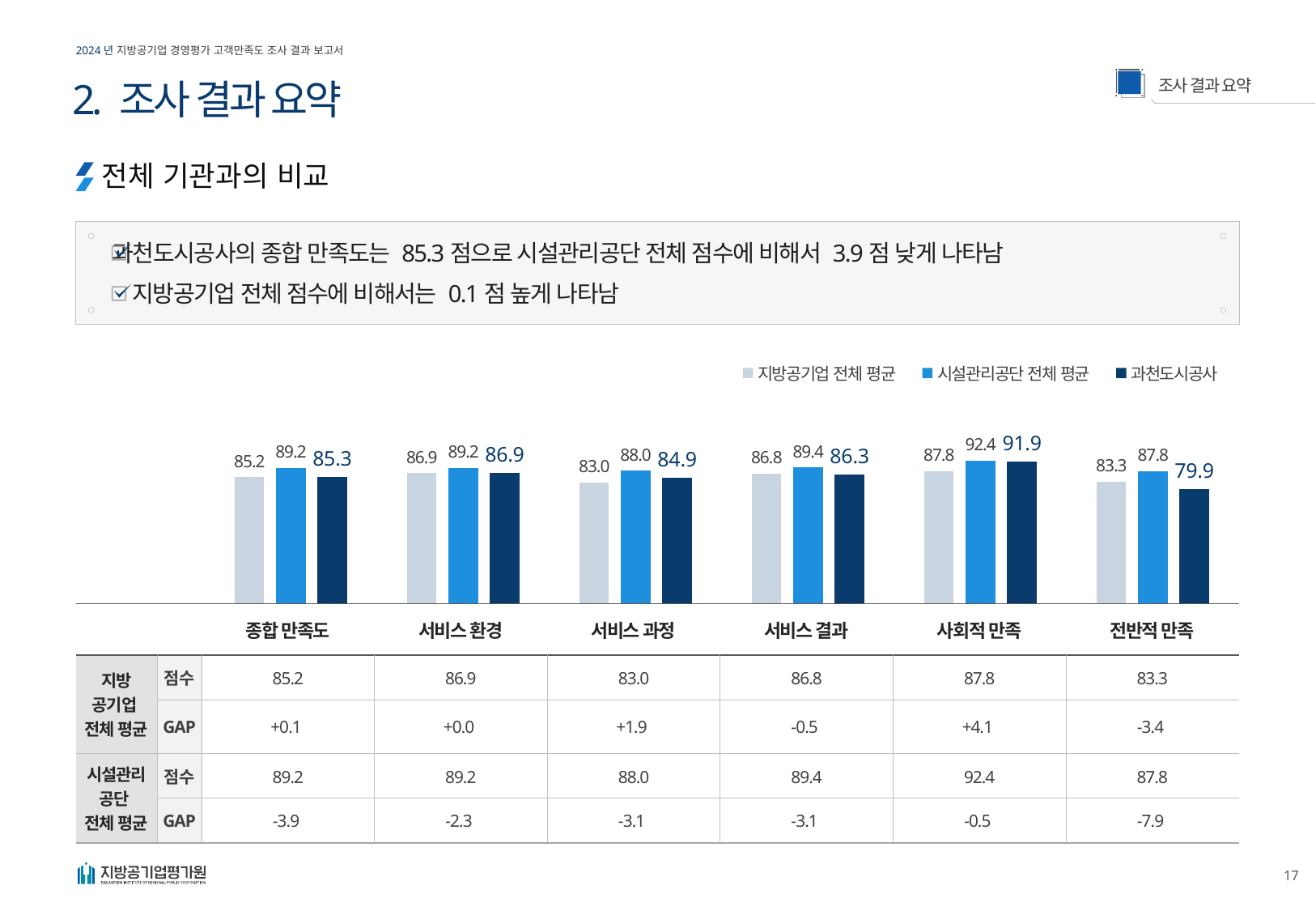
What is the difference between 과천도시공사 and 지방공기업 전체 평균 in the 사회적 만족 category? 4.1 In which category does 과천도시공사 have its lowest value? 전반적 만족 In which category does 과천도시공사 have its highest value? 사회적 만족 In the 서비스 과정 category, which is larger: 시설관리공단 전체 평균 or 과천도시공사? 시설관리공단 전체 평균 What kind of chart is shown on the slide? bar chart How many categories are shown on the x axis of the chart? 6 What is the value for 시설관리공단 전체 평균 in the 사회적 만족 category? 92.4 What is the value for 과천도시공사 in the 종합 만족도 category? 85.3 How many series does the chart legend list? 3 Which series is shown in the darkest blue colour in the chart? 과천도시공사 What is the difference between 시설관리공단 전체 평균 and 과천도시공사 in the 전반적 만족 category? 7.9 What is the value for 지방공기업 전체 평균 in the 서비스 과정 category? 83.0